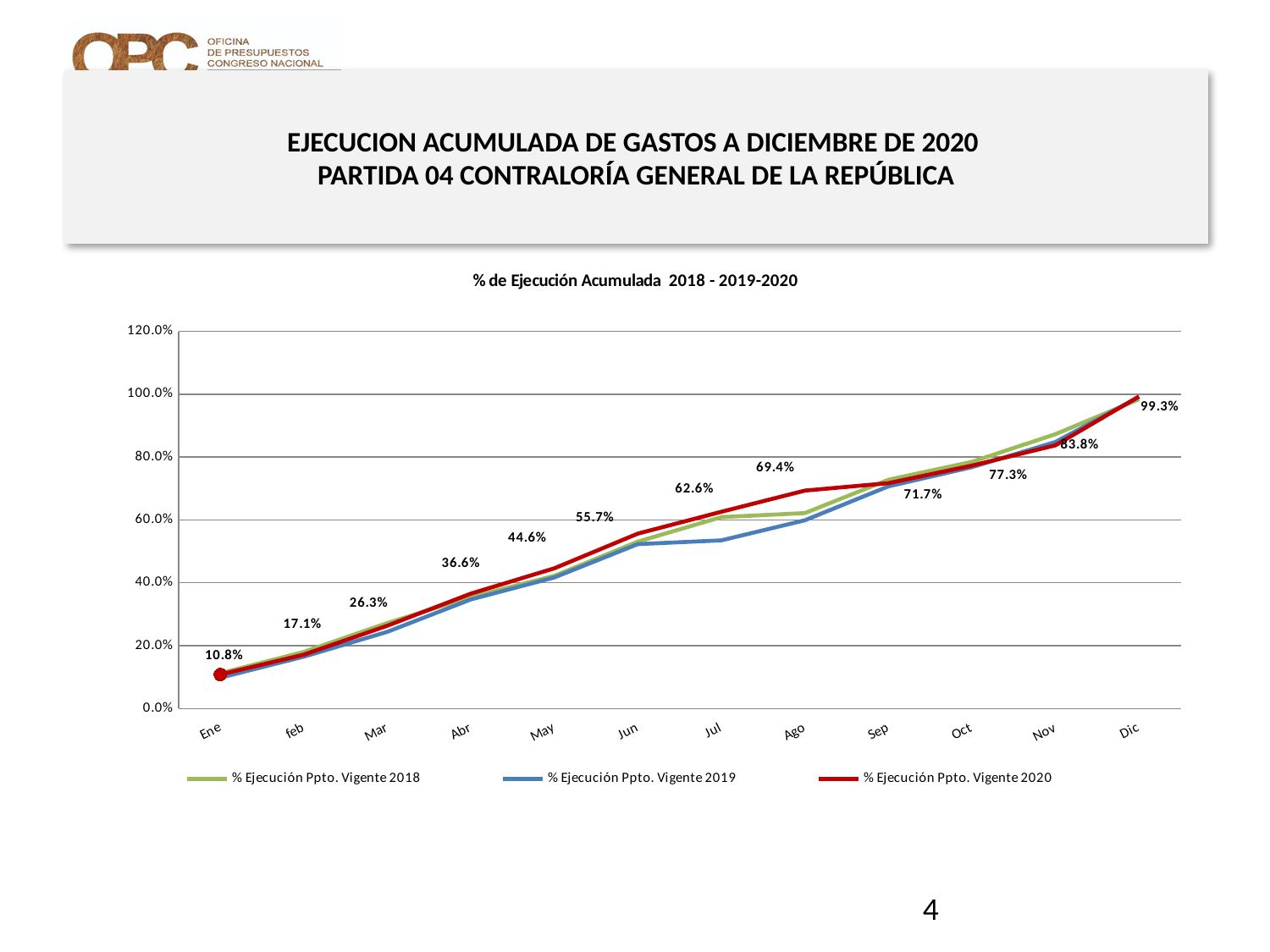
What is the value for % Ejecución Ppto. Vigente 2020 in Ene? 10.8% In which month is the % Ejecución Ppto. Vigente 2020 value lowest? Ene What type of chart is shown on the slide? Line chart Is the value for % Ejecución Ppto. Vigente 2019 in Jul greater or less than 60.0%? less What is the value for % Ejecución Ppto. Vigente 2020 in Dic? 99.3% How many months are shown on the x axis? 12 How many series does the legend list? 3 In which month is the % Ejecución Ppto. Vigente 2020 value highest? Dic What is the value for % Ejecución Ppto. Vigente 2020 in Jun? 55.7% What is the value for % Ejecución Ppto. Vigente 2020 in Sep? 71.7% What is the difference between the % Ejecución Ppto. Vigente 2020 values for Dic and Nov? 15.5% Do the % Ejecución Ppto. Vigente 2020 values rise or fall from Ene to Dic? Rise